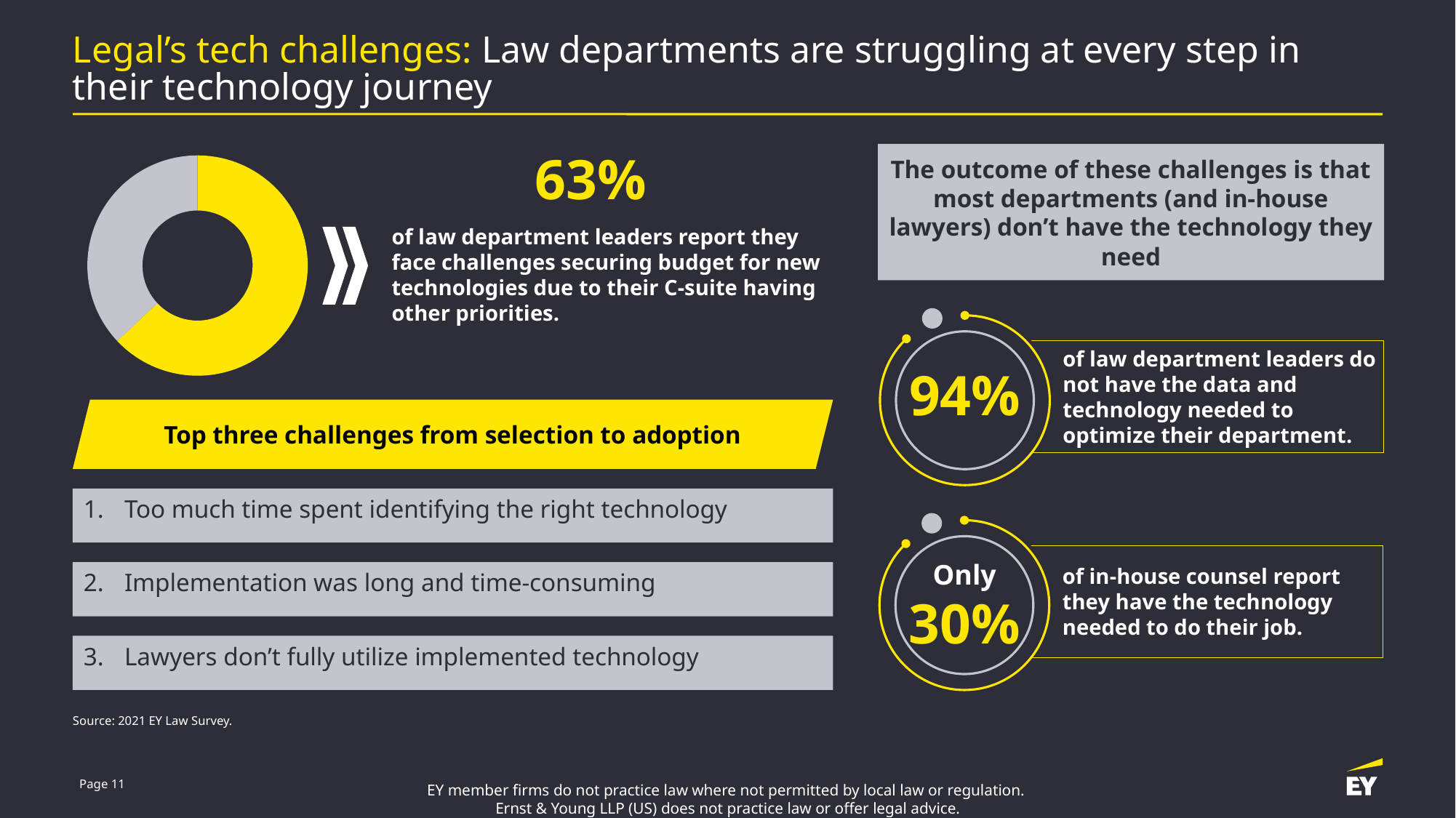
What share of the donut chart is taken up by the grey segment? 37% Is the yellow segment of the donut chart greater or less than 50% of the whole? greater What percentage does the yellow segment of the donut chart represent? 63% What share of the donut chart is taken up by the yellow segment? 63% Is the grey segment of the donut chart greater or less than 50% of the whole? less How many segments does the donut chart have? 2 Which segment of the donut chart is larger, the yellow one or the grey one? yellow What colour is the segment of the donut chart that represents 63%? yellow What kind of chart is shown on the left of the slide? donut (pie) chart According to the text next to the donut chart, what does the 63% figure represent? law department leaders who report they face challenges securing budget for new technologies due to their C-suite having other priorities